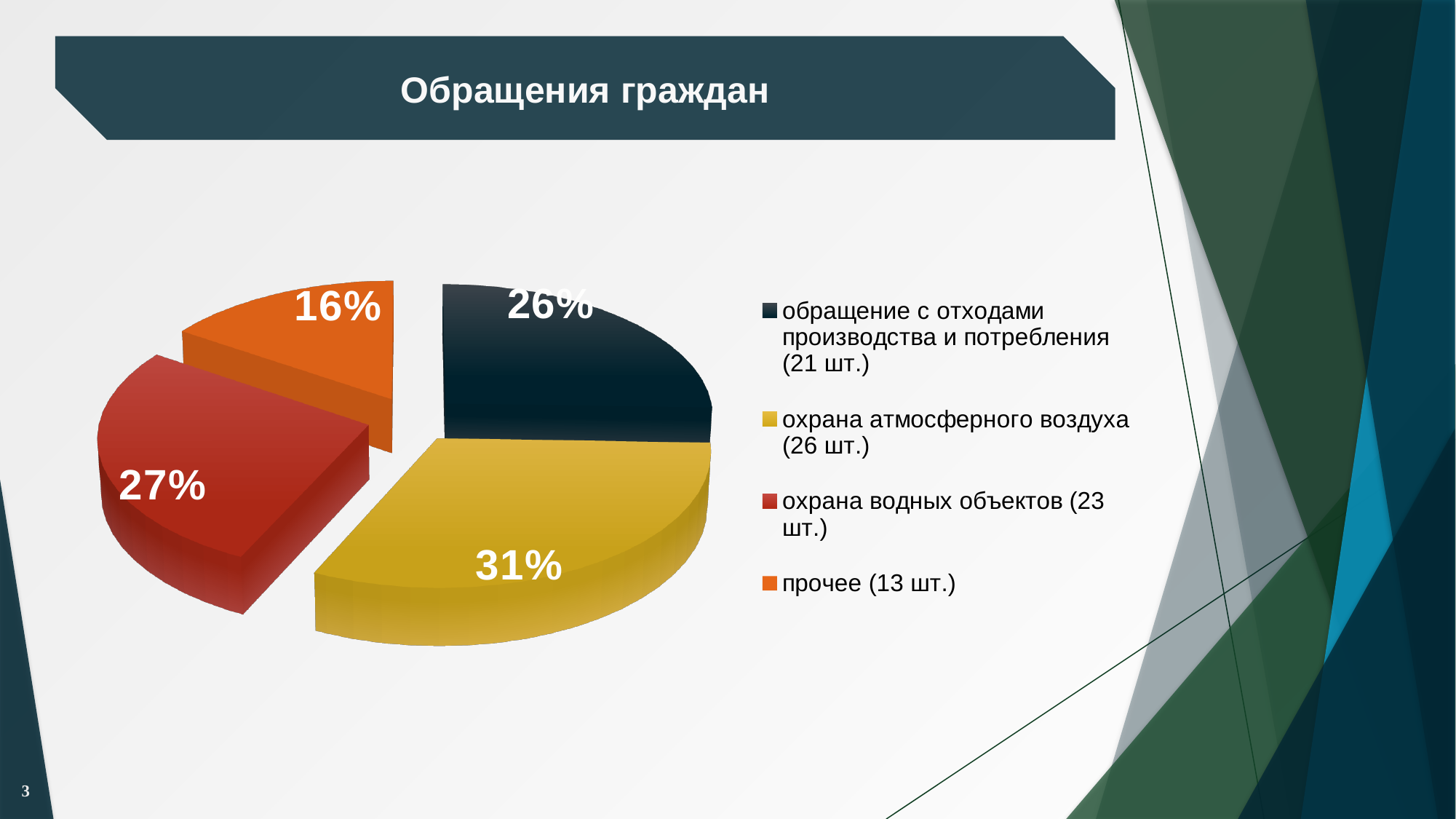
What is the difference in percentage points between the "охрана атмосферного воздуха" slice and the "прочее" slice? 15% Which category has the smallest share of the pie? прочее Which category has the largest share of the pie? охрана атмосферного воздуха What percentage share does the slice "обращение с отходами производства и потребления" have? 26% What is the title of the chart? Обращения граждан Which colour is used for the "прочее" slice? orange How many appeals (шт.) does the legend give for "охрана водных объектов"? 23 шт. What percentage share does the slice "прочее" have? 16% How many slices does the pie chart have? 4 What percentage share does the slice "охрана атмосферного воздуха" have? 31% What kind of chart is shown on the slide? pie chart